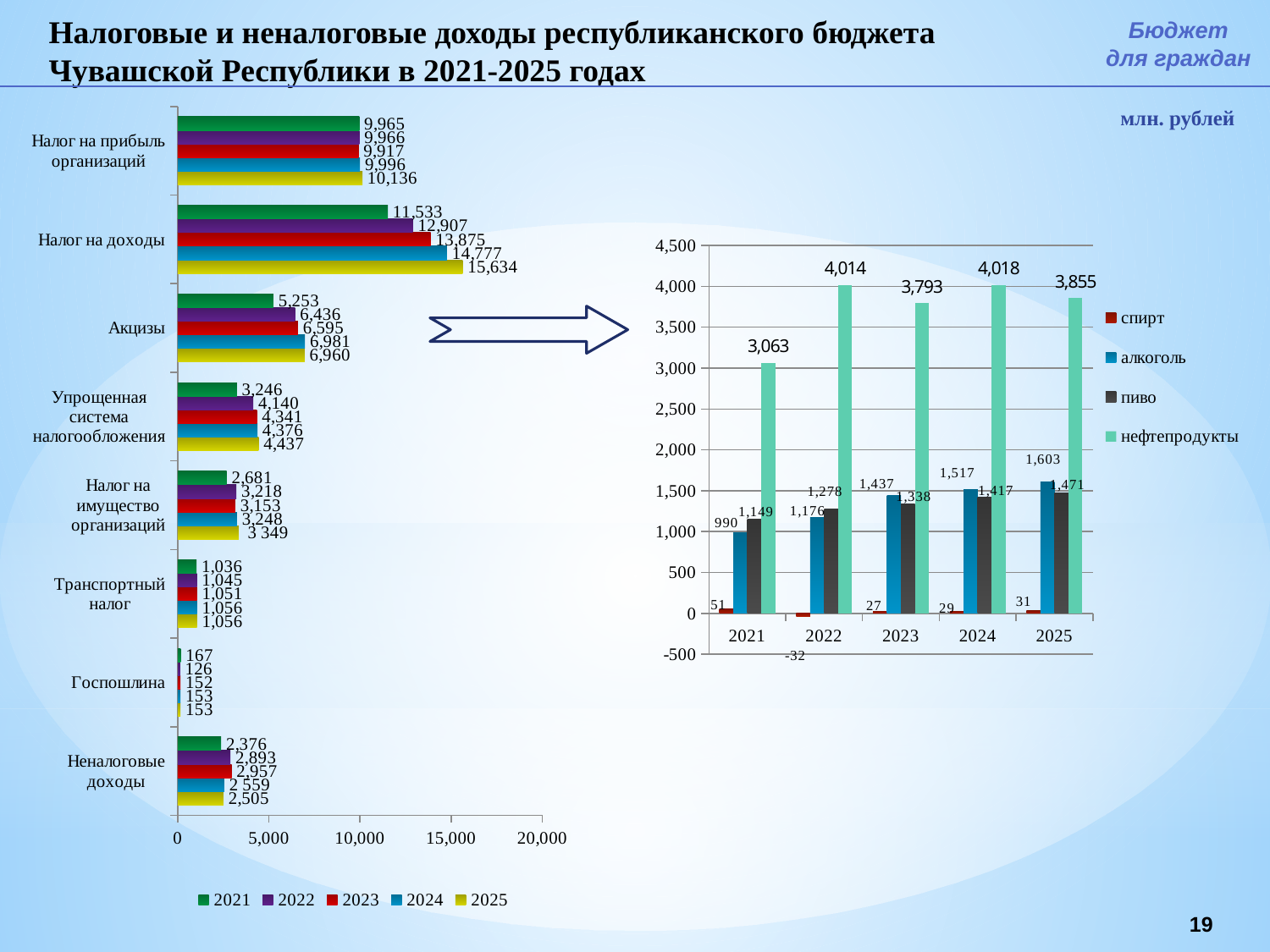
In the left chart, what is the value for Акцизы in 2021? 5,253 In the right chart, which is larger in 2024: алкоголь or пиво? алкоголь In the left chart, how many categories are shown on the vertical axis? 8 In the right chart, what is the value for нефтепродукты in 2022? 4,014 In the left chart, how many series does the legend list? 5 In the left chart, which year has the highest value for Налог на доходы? 2025 In the left chart, which year has the lowest value for Госпошлина? 2022 In the left chart, what is the difference between the 2025 and 2021 values for Налог на доходы? 4,101 In the right chart, what is the value for спирт in 2022? -32 In the right chart, does the value for алкоголь rise or fall from 2021 to 2025? rise In the left chart, what is the value for Налог на доходы in 2025? 15,634 What kind of chart is the right chart? bar chart